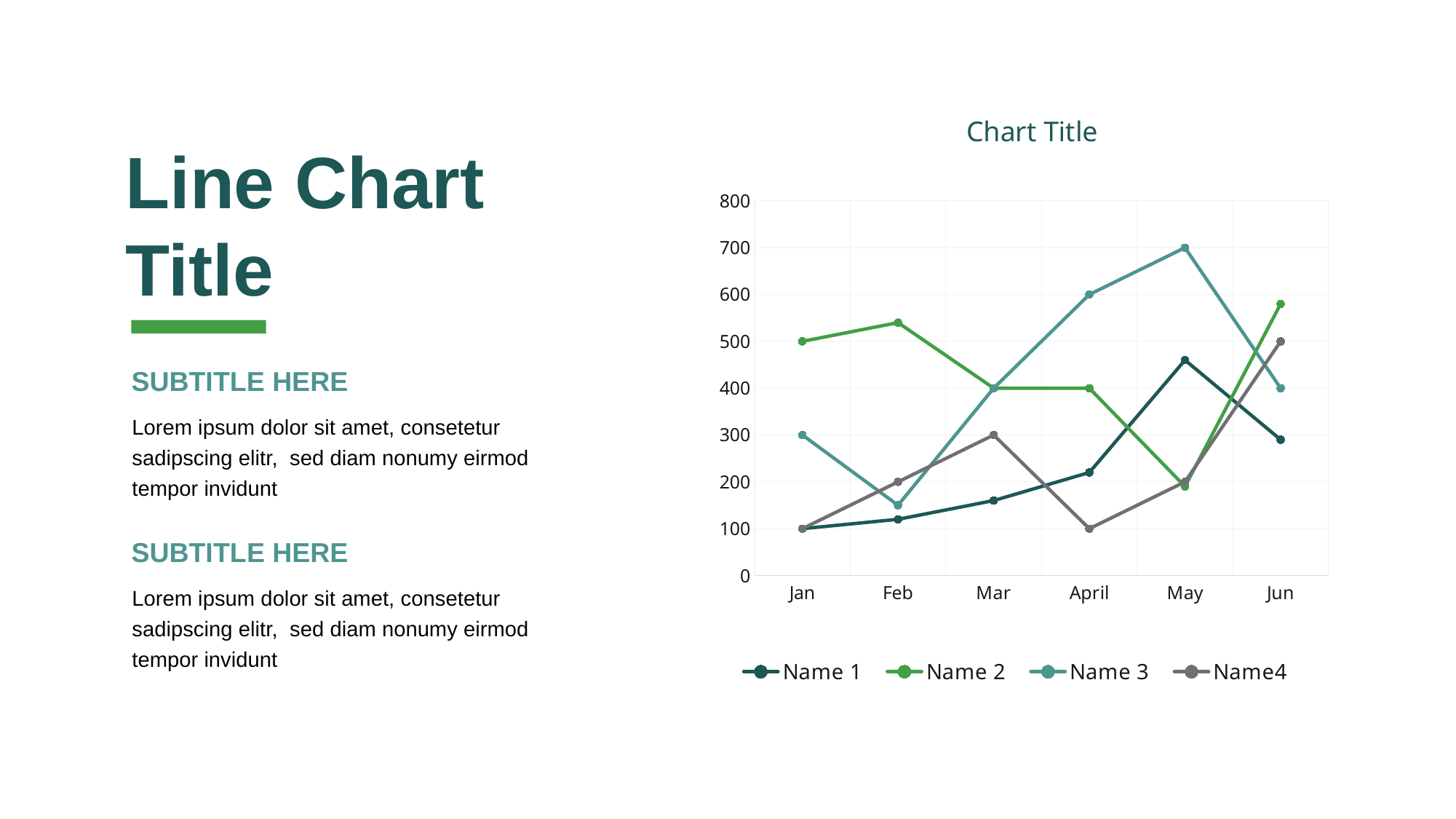
How many months are shown on the x axis? 6 What is the difference between Name 3 in May and Name 3 in Jun? 300 What is the value for Name 3 in April? 600 In which month does Name 3 reach its highest value? May What is the value for Name 2 in Jan? 500 What is the value for Name4 in Jun? 500 How many series does the legend list? 4 Is the value for Name 1 in May greater or less than 400? greater Which is larger in Feb, Name 2 or Name 3? Name 2 In which month does Name 1 reach its highest value? May What kind of chart is shown on the slide? line chart What is the value for Name 3 in May? 700